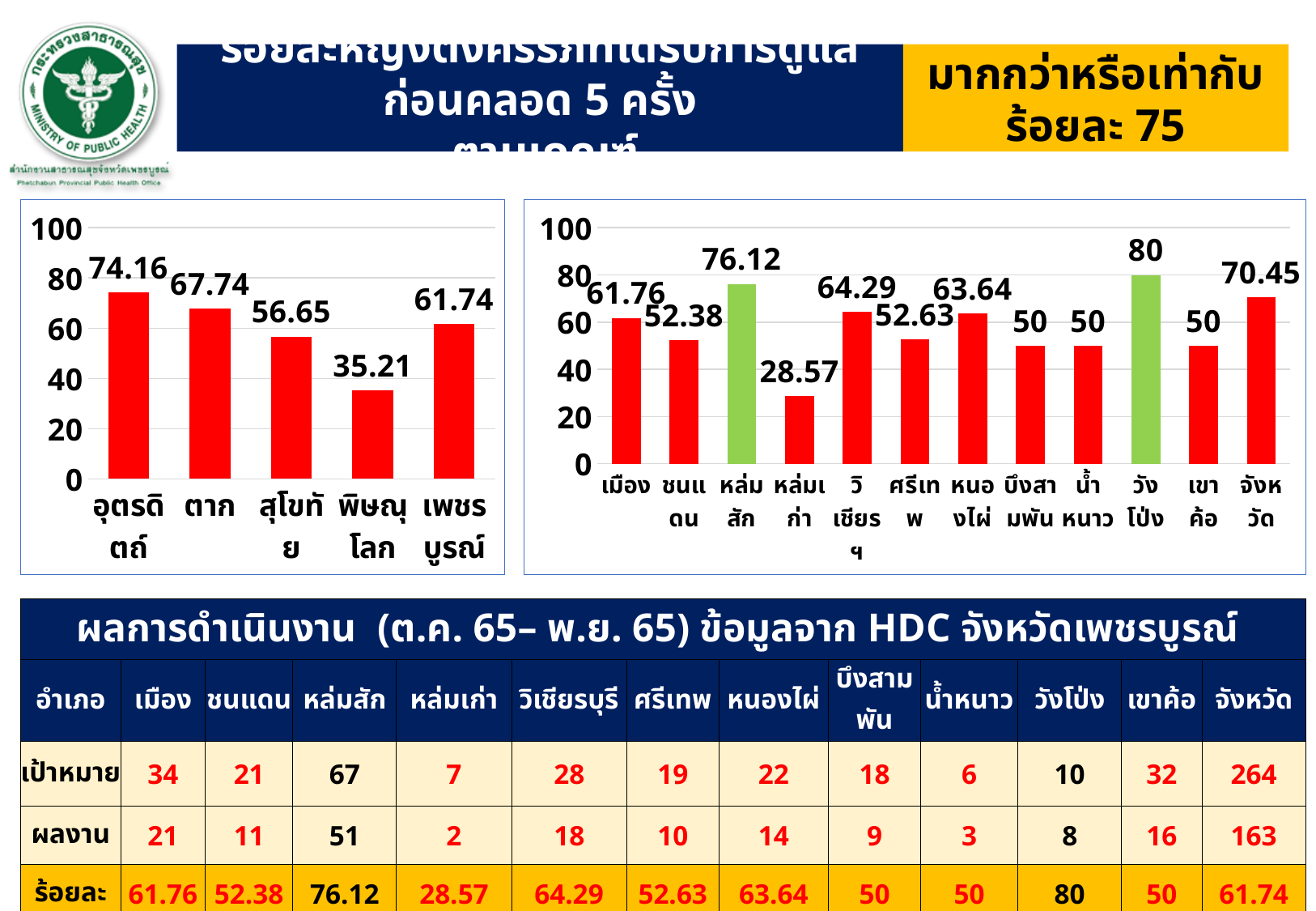
In the right chart, which category has the highest value? วังโป่ง In the right chart, what is the value for หล่มสัก? 76.12 In the left chart, what is the difference between the values for อุตรดิตถ์ and พิษณุโลก? 38.95 In the right chart, which is larger, the value for วิเชียรบุรี or the value for ศรีเทพ? วิเชียรบุรี In the left chart, which category has the lowest value? พิษณุโลก In the left chart, what is the value for ตาก? 67.74 In the right chart, which category has the lowest value? หล่มเก่า How many categories are shown in the right chart? 12 In the right chart, how many bars are coloured green? 2 What type of chart is the right chart? Bar chart How many categories are shown in the left chart? 5 In the left chart, which category has the highest value? อุตรดิตถ์